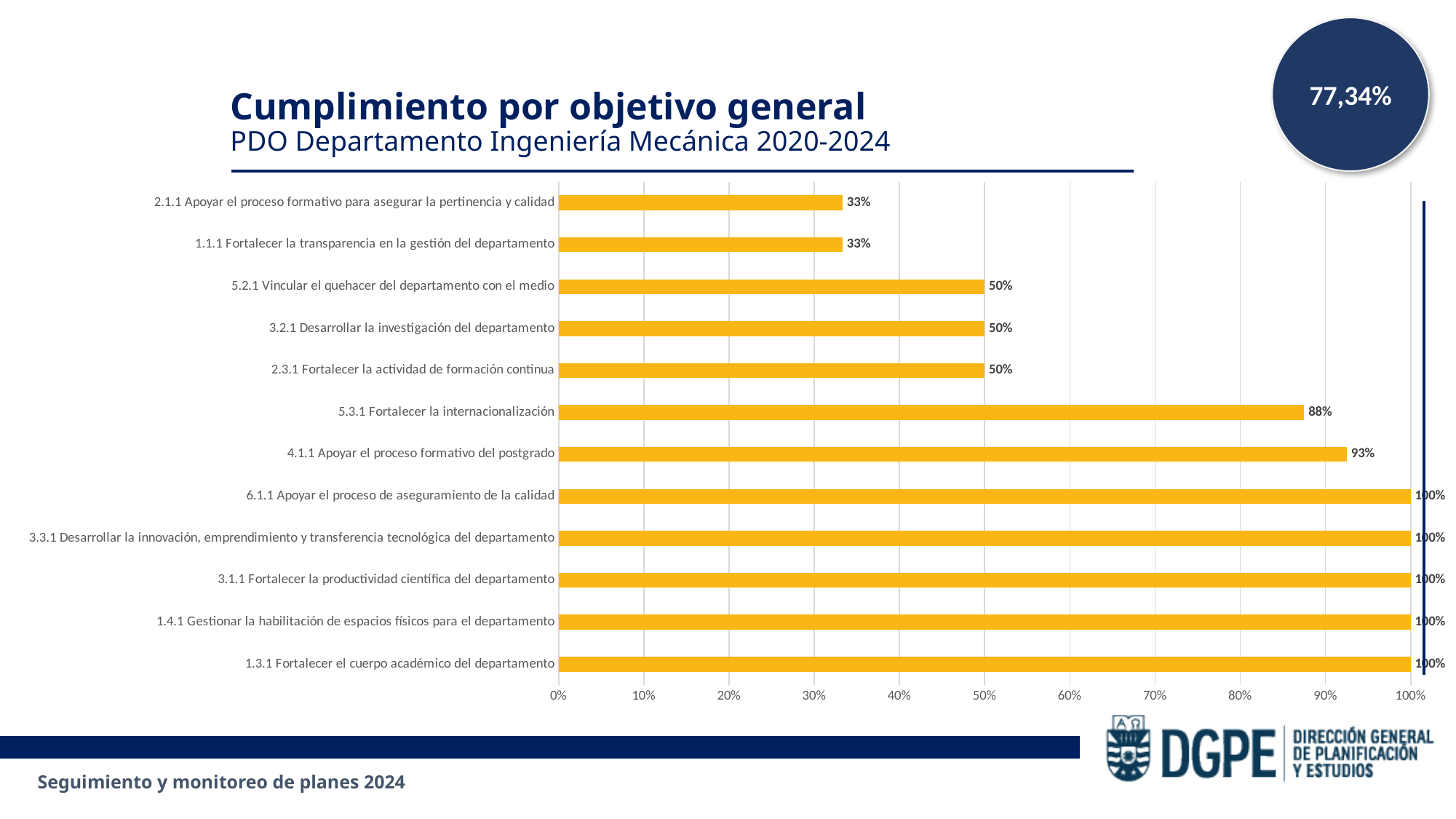
What is the difference between the values for 3.2.1 Desarrollar la investigación del departamento and 2.1.1 Apoyar el proceso formativo para asegurar la pertinencia y calidad? 17% What is the value for 5.2.1 Vincular el quehacer del departamento con el medio? 50% What kind of chart is shown on the slide? Bar chart Which has the larger value, 5.3.1 Fortalecer la internacionalización or 2.3.1 Fortalecer la actividad de formación continua? 5.3.1 Fortalecer la internacionalización How many categories have a value of 100%? 5 What is the value for 1.1.1 Fortalecer la transparencia en la gestión del departamento? 33% What is the value for 4.1.1 Apoyar el proceso formativo del postgrado? 93% What is the difference between the values for 4.1.1 Apoyar el proceso formativo del postgrado and 5.3.1 Fortalecer la internacionalización? 5% What is the title of the chart? Cumplimiento por objetivo general What is the value for 5.3.1 Fortalecer la internacionalización? 88% How many categories (objectives) are shown in the chart? 12 Is the value for 5.3.1 Fortalecer la internacionalización greater or less than 80%? greater